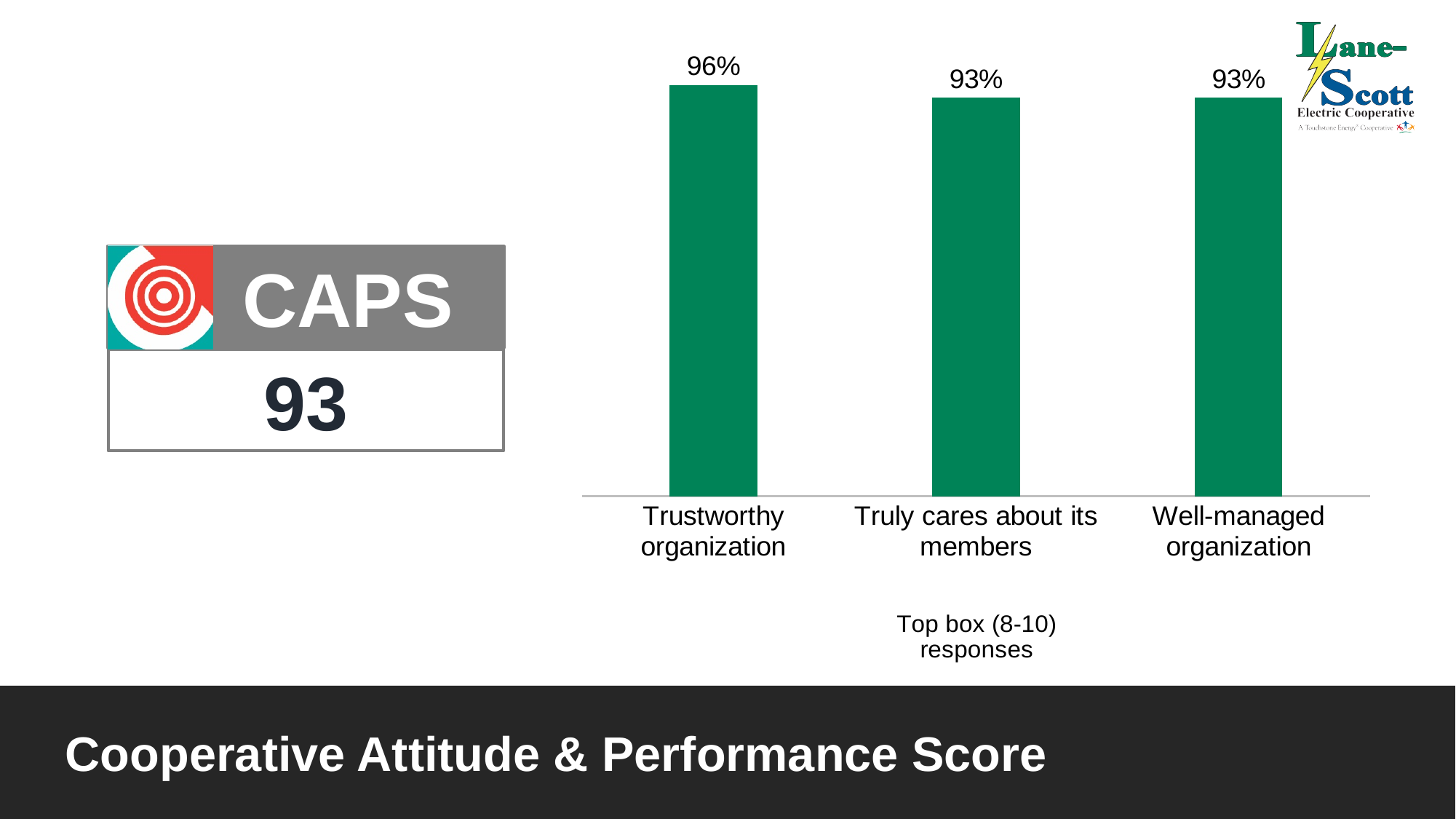
Which is larger, the value for Trustworthy organization or the value for Truly cares about its members? Trustworthy organization What kind of chart is shown on the slide? Bar chart What does the text below the x axis say the bars represent? Top box (8-10) responses What is the value for Truly cares about its members? 93% Which category has the highest value? Trustworthy organization How many categories are shown in the chart? 3 What is the value for Trustworthy organization? 96% Do the values rise or fall from Trustworthy organization to Truly cares about its members? Fall What colour are the bars in the chart? Green What is the value for Well-managed organization? 93% What is the difference between the values for Trustworthy organization and Well-managed organization? 3%